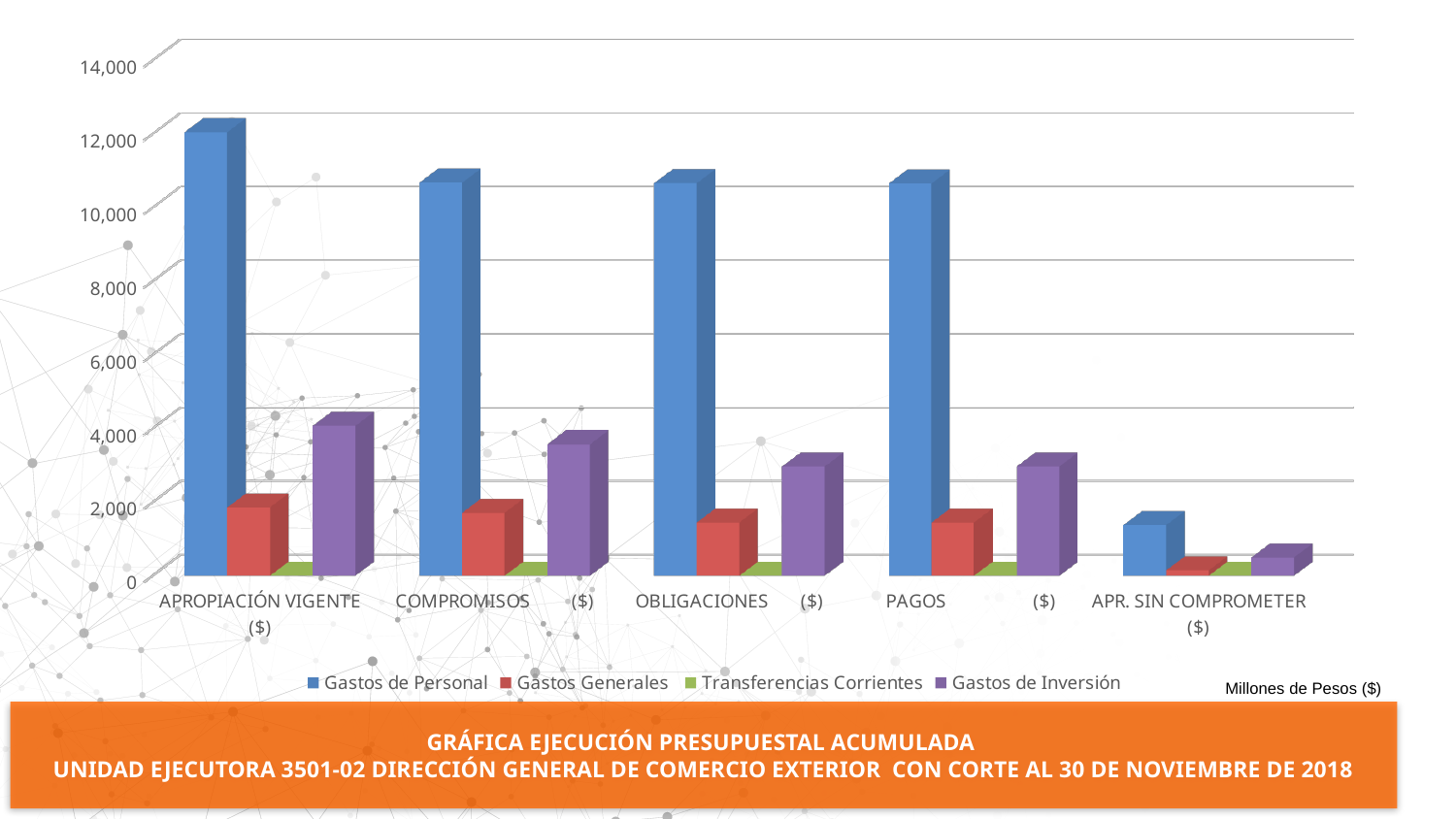
In the APROPIACIÓN VIGENTE ($) category, which is larger: Gastos de Inversión or Gastos Generales? Gastos de Inversión Is the Gastos de Personal value for APROPIACIÓN VIGENTE ($) greater or less than 10,000? greater What kind of chart is shown on the slide? Bar chart Which series has the lowest value in the APROPIACIÓN VIGENTE ($) category? Transferencias Corrientes Is the Gastos de Inversión value for PAGOS ($) greater or less than 4,000? less Is the Gastos Generales value for OBLIGACIONES ($) greater or less than 2,000? less How many categories are shown on the x axis? 5 What unit is indicated for the values in the chart? Millones de Pesos ($) Do the Gastos de Inversión values generally rise or fall from APROPIACIÓN VIGENTE ($) to APR. SIN COMPROMETER ($)? fall Which category has the highest Gastos de Personal value? APROPIACIÓN VIGENTE ($) Which category has the lowest Gastos de Personal value? APR. SIN COMPROMETER ($) How many series does the legend list? 4